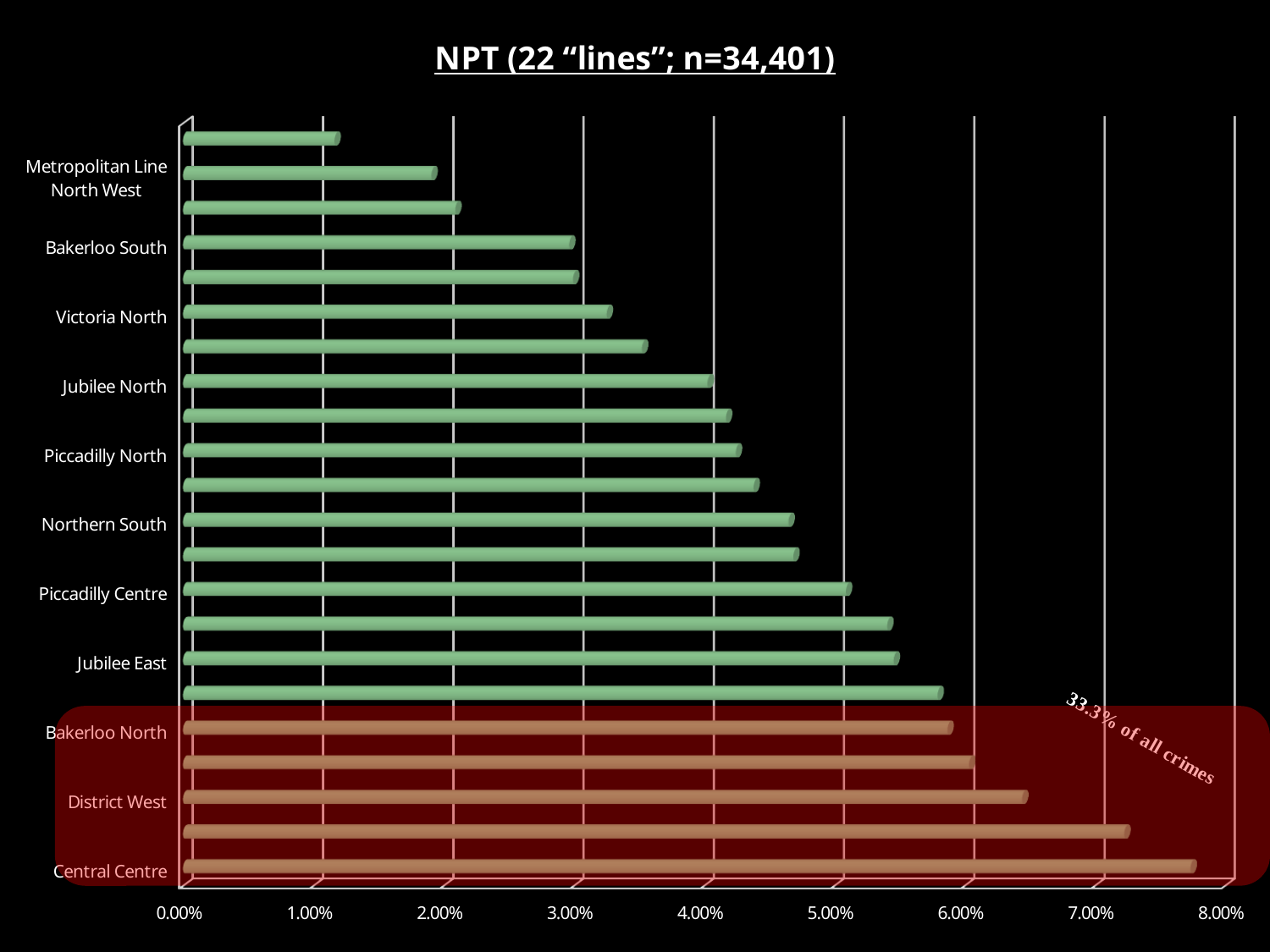
What text is written in the highlighted red area at the bottom of the chart? 33.3% of all crimes Is the value for Central Centre greater or less than 7.00%? greater Which has the larger value, Central Centre or Metropolitan Line North West? Central Centre What is the title of the chart? NPT (22 "lines"; n=34,401) Is the value for Jubilee East greater or less than 5.00%? greater Is the value for Northern South greater or less than 5.00%? less What kind of chart is shown on the slide? bar chart How many bars are plotted in the chart? 22 Which labelled line has the highest value in the chart? Central Centre